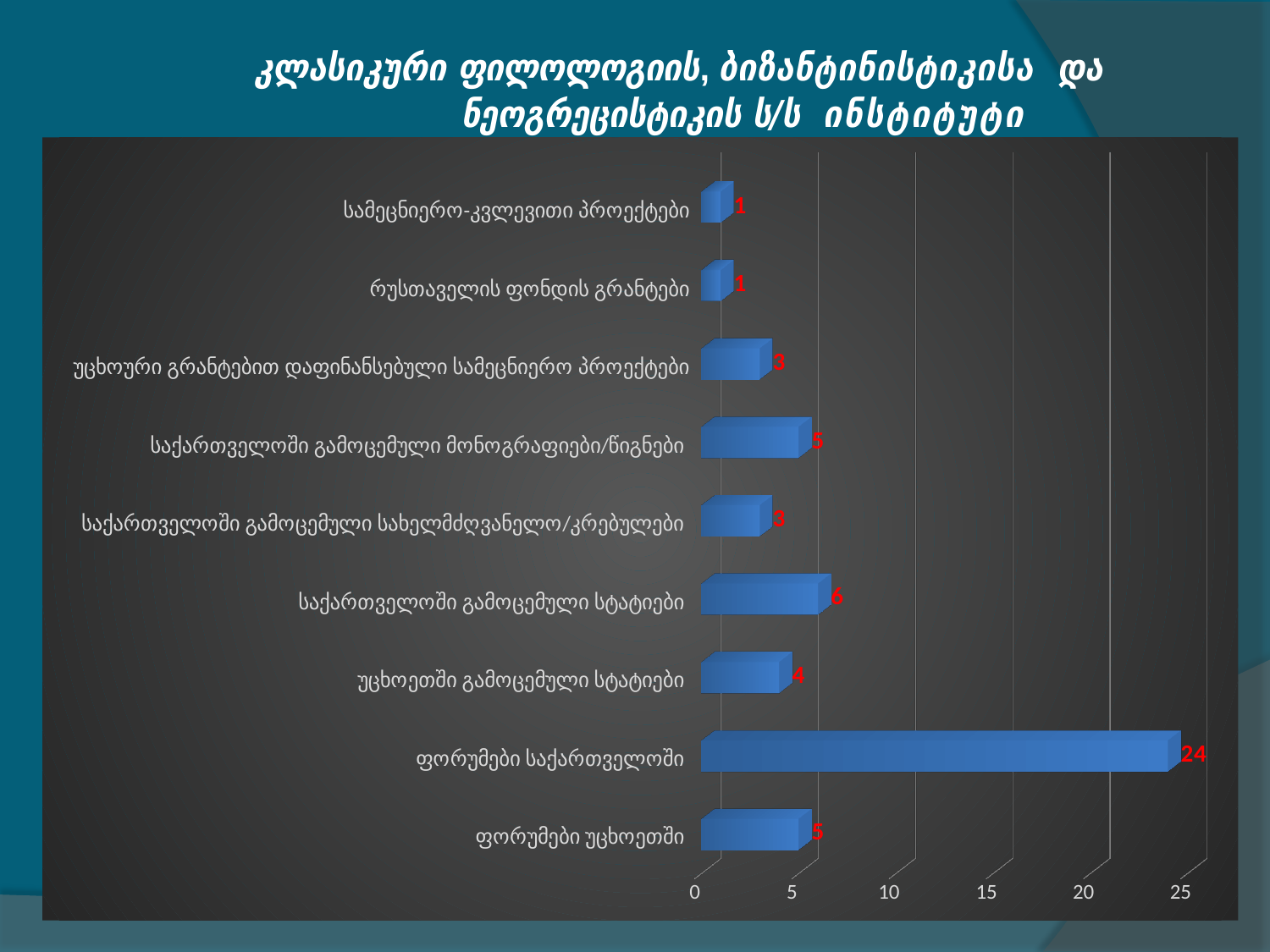
Which category has the highest value? ფორუმები საქართველოში What is the value for რუსთაველის ფონდის გრანტები? 1 What is the value for საქართველოში გამოცემული სტატიები? 6 What is the value for ფორუმები საქართველოში? 24 Is the value for ფორუმები საქართველოში greater or less than 20? greater What is the value for უცხოეთში გამოცემული სტატიები? 4 How many categories are shown in the chart? 9 What is the difference between ფორუმები საქართველოში and ფორუმები უცხოეთში? 19 What is the highest value shown on the horizontal axis? 25 What kind of chart is shown on the slide? bar chart Which is larger: საქართველოში გამოცემული სტატიები or უცხოეთში გამოცემული სტატიები? საქართველოში გამოცემული სტატიები What is the difference between საქართველოში გამოცემული მონოგრაფიები/წიგნები and უცხოური გრანტებით დაფინანსებული სამეცნიერო პროექტები? 2